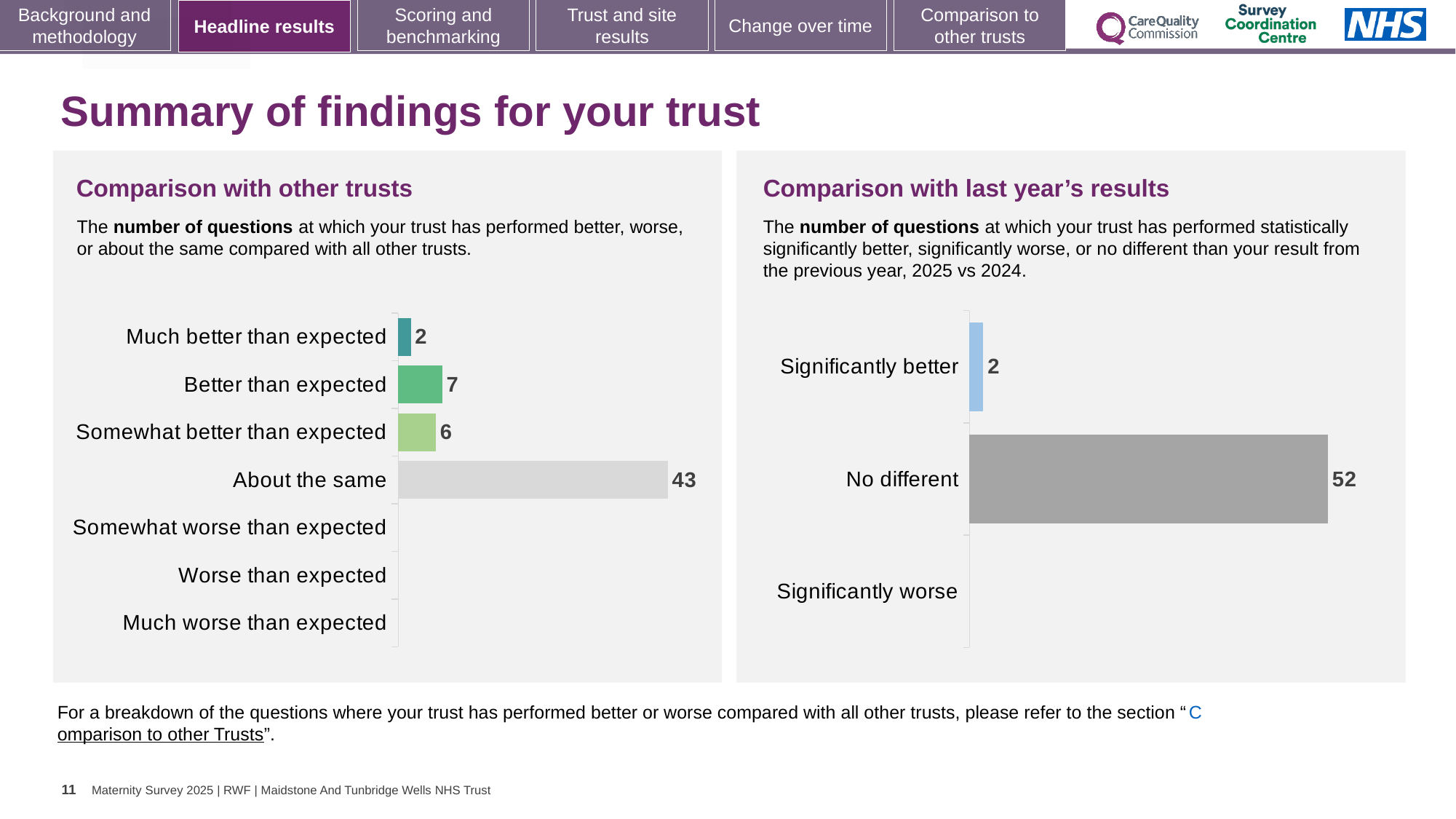
In the 'Comparison with other trusts' chart, what is the difference between 'About the same' and 'Better than expected'? 36 In the 'Comparison with other trusts' chart, what is the value for 'Better than expected'? 7 In the 'Comparison with other trusts' chart, which category has the highest value? About the same In the 'Comparison with last year's results' chart, what is the value for 'Significantly better'? 2 How many categories are listed in the 'Comparison with last year's results' chart? 3 How many categories are listed in the 'Comparison with other trusts' chart? 7 In the 'Comparison with last year's results' chart, what is the value for 'No different'? 52 In the 'Comparison with last year's results' chart, what is the difference between 'No different' and 'Significantly better'? 50 In the 'Comparison with other trusts' chart, what is the value for 'Somewhat better than expected'? 6 In the 'Comparison with other trusts' chart, which is larger: 'Better than expected' or 'Much better than expected'? Better than expected In the 'Comparison with other trusts' chart, how many questions are 'About the same'? 43 What type of chart is the 'Comparison with other trusts' chart? Bar chart